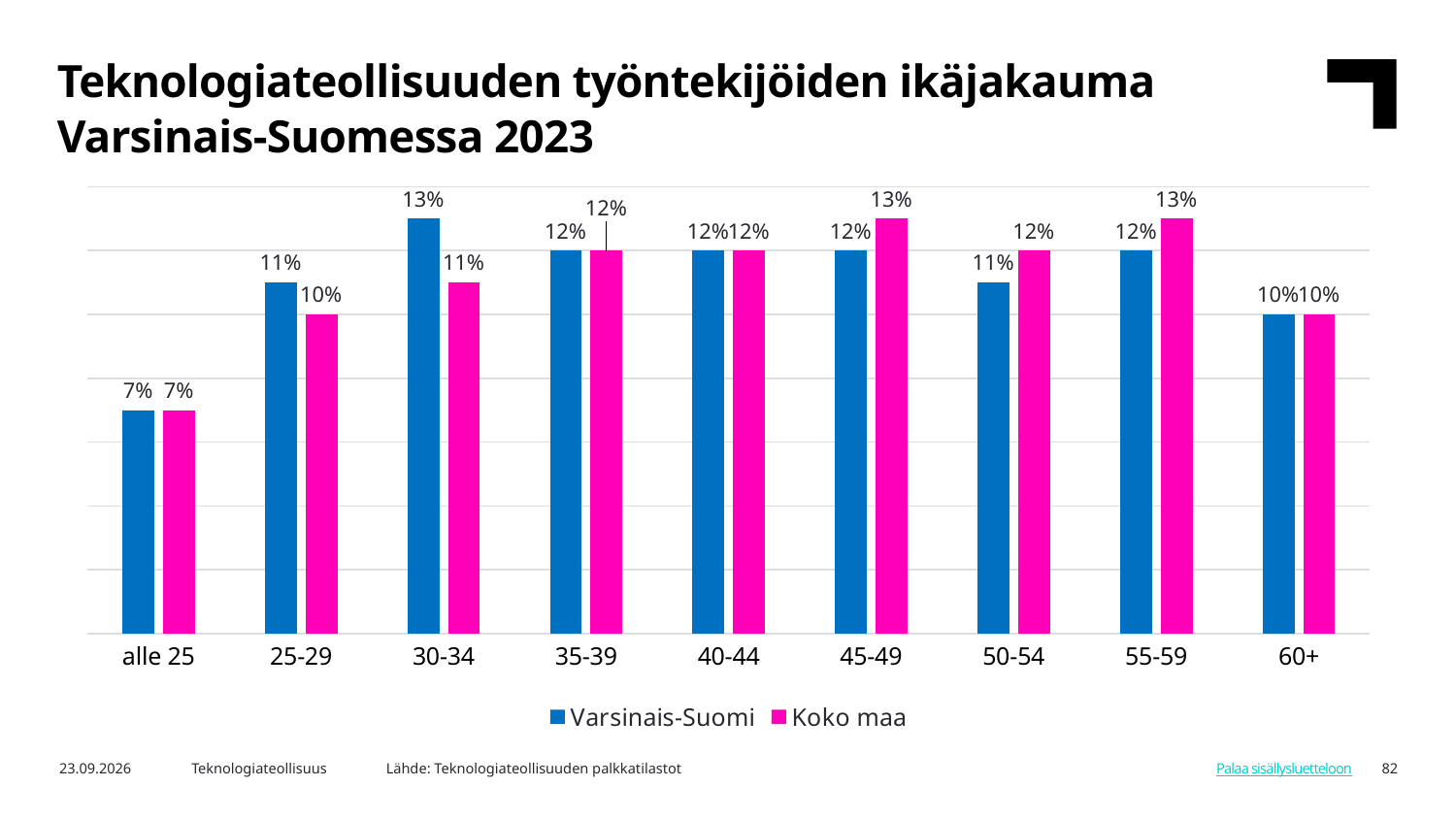
Which age group has the lowest value for Koko maa? alle 25 In the 45-49 age group, which series has the larger value, Varsinais-Suomi or Koko maa? Koko maa What is the difference between Varsinais-Suomi and Koko maa in the 30-34 age group? 2% In the 25-29 age group, which series has the larger value, Varsinais-Suomi or Koko maa? Varsinais-Suomi What is the value for Koko maa in the 25-29 age group? 10% How many series does the legend list? 2 What is the value for Varsinais-Suomi in the 30-34 age group? 13% What kind of chart is shown on the slide? bar chart What is the value for Koko maa in the 50-54 age group? 12% How many age categories are shown on the x axis? 9 Which colour represents the Koko maa series? pink Which age group has the highest value for Varsinais-Suomi? 30-34